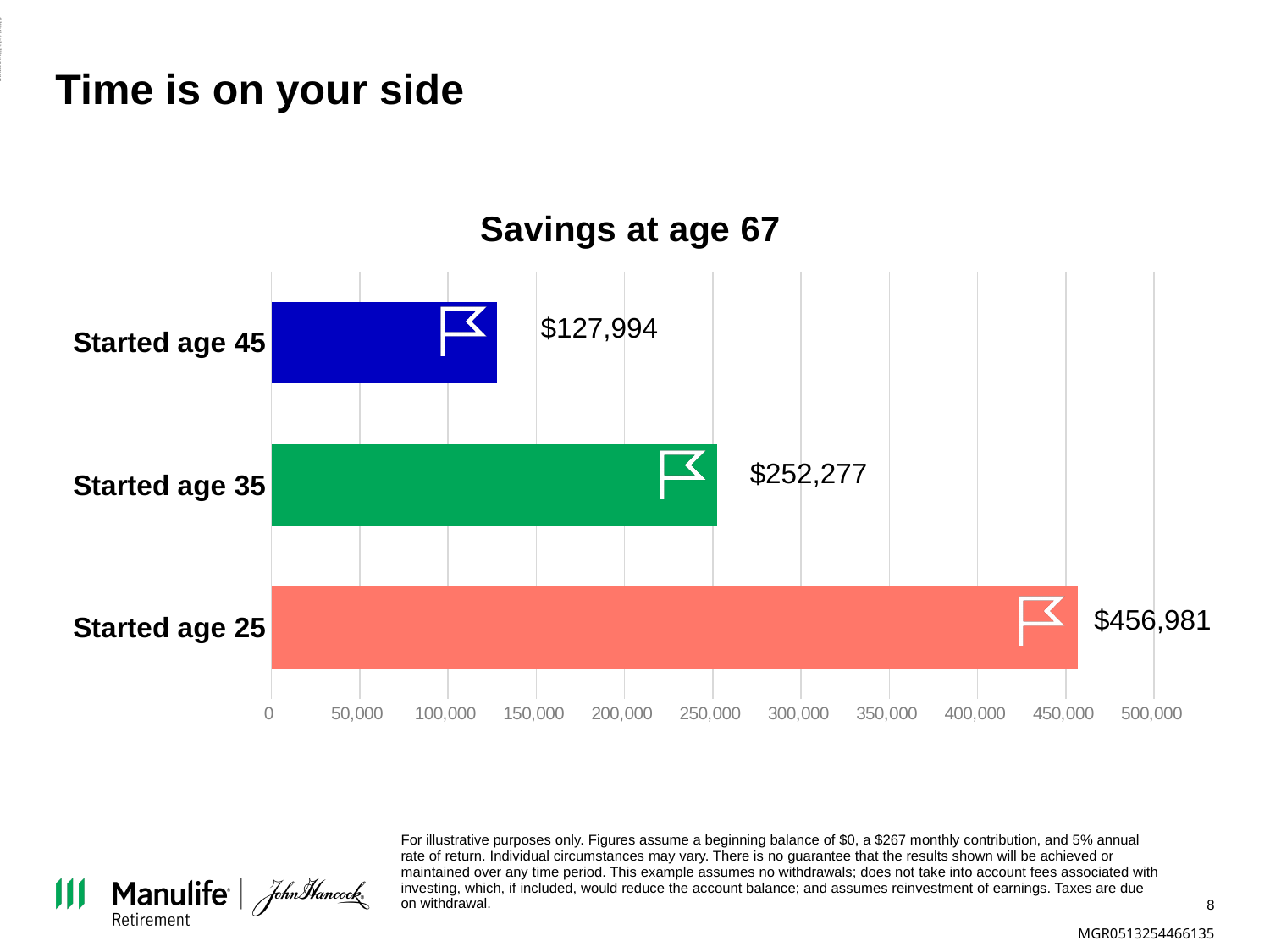
Is the savings value for 'Started age 25' greater or less than 400,000? greater How many starting-age categories are shown in the chart? 3 What is the difference in savings at age 67 between starting at age 35 and starting at age 45? $124,283 What is the savings value at age 67 for someone who started at age 35? $252,277 What is the savings value at age 67 for someone who started at age 25? $456,981 What kind of chart is used to show savings at age 67? Bar chart Which starting age results in the highest savings at age 67? Started age 25 Which starting age results in the lowest savings at age 67? Started age 45 What is the savings value at age 67 for someone who started at age 45? $127,994 Which has larger savings at age 67: starting at age 35 or starting at age 45? Started age 35 What is the difference in savings at age 67 between starting at age 25 and starting at age 45? $328,987 What is the title of the chart? Savings at age 67